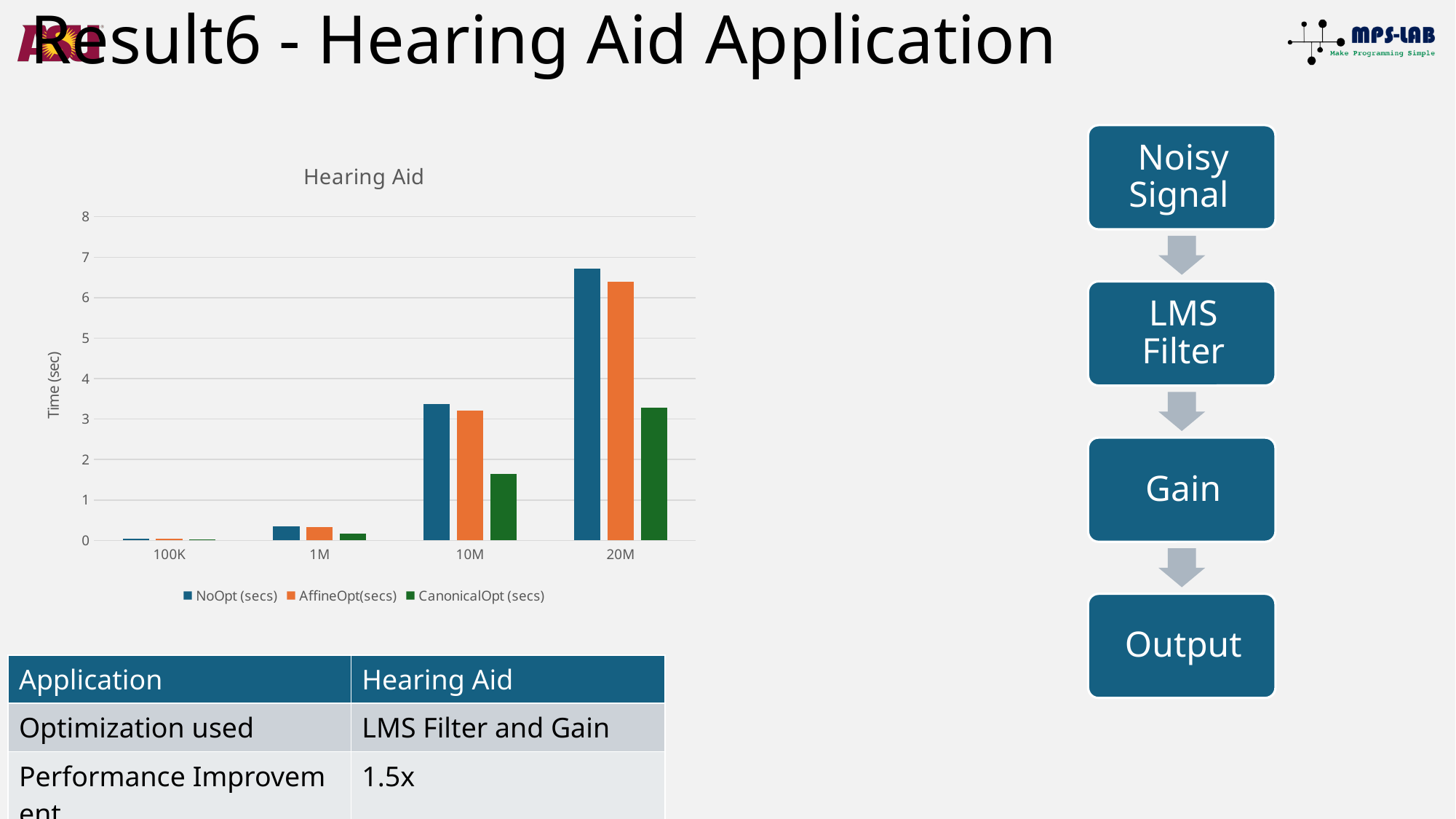
What is the y-axis title of the Hearing Aid chart? Time (sec) What kind of chart is the Hearing Aid chart? bar chart How many input-size categories are shown on the x axis of the Hearing Aid chart? 4 In the Hearing Aid chart, is the CanonicalOpt (secs) value for 20M greater or less than 4? less In the Hearing Aid chart, is the NoOpt (secs) value for 20M greater or less than 6? greater In the Hearing Aid chart, is the CanonicalOpt (secs) value for 10M greater or less than 2? less In the Hearing Aid chart, at 10M, which is larger: NoOpt (secs) or CanonicalOpt (secs)? NoOpt (secs) In the Hearing Aid chart, at 20M, which is larger: AffineOpt(secs) or CanonicalOpt (secs)? AffineOpt(secs) How many series does the legend of the Hearing Aid chart list? 3 In the Hearing Aid chart, do the NoOpt (secs) values rise or fall from 100K to 20M? rise In the Hearing Aid chart, which category has the lowest CanonicalOpt (secs) value? 100K In the Hearing Aid chart, which category has the highest NoOpt (secs) value? 20M